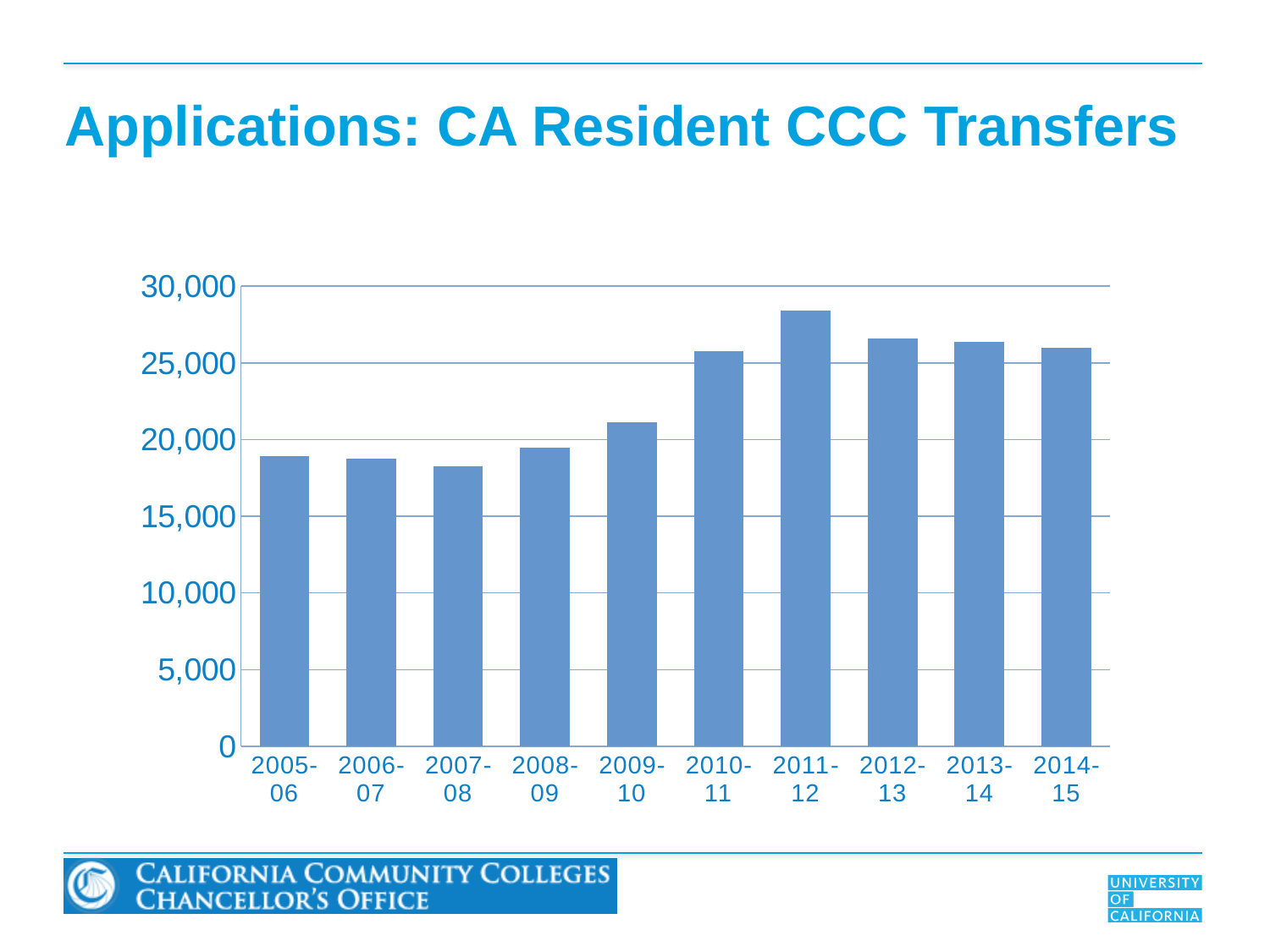
Which academic year has the highest number of applications? 2011-12 Is the value for 2014-15 greater or less than 25,000? greater Is the value for 2005-06 greater or less than 20,000? less How many academic years are shown on the x axis of the chart? 10 What is the title of the slide's chart? Applications: CA Resident CCC Transfers What kind of chart is shown on the slide? Bar chart Do the values generally rise or fall from 2007-08 to 2011-12? rise Is the value for 2011-12 greater or less than 25,000? greater Which is larger, the value for 2011-12 or the value for 2014-15? 2011-12 Which is larger, the value for 2010-11 or the value for 2009-10? 2010-11